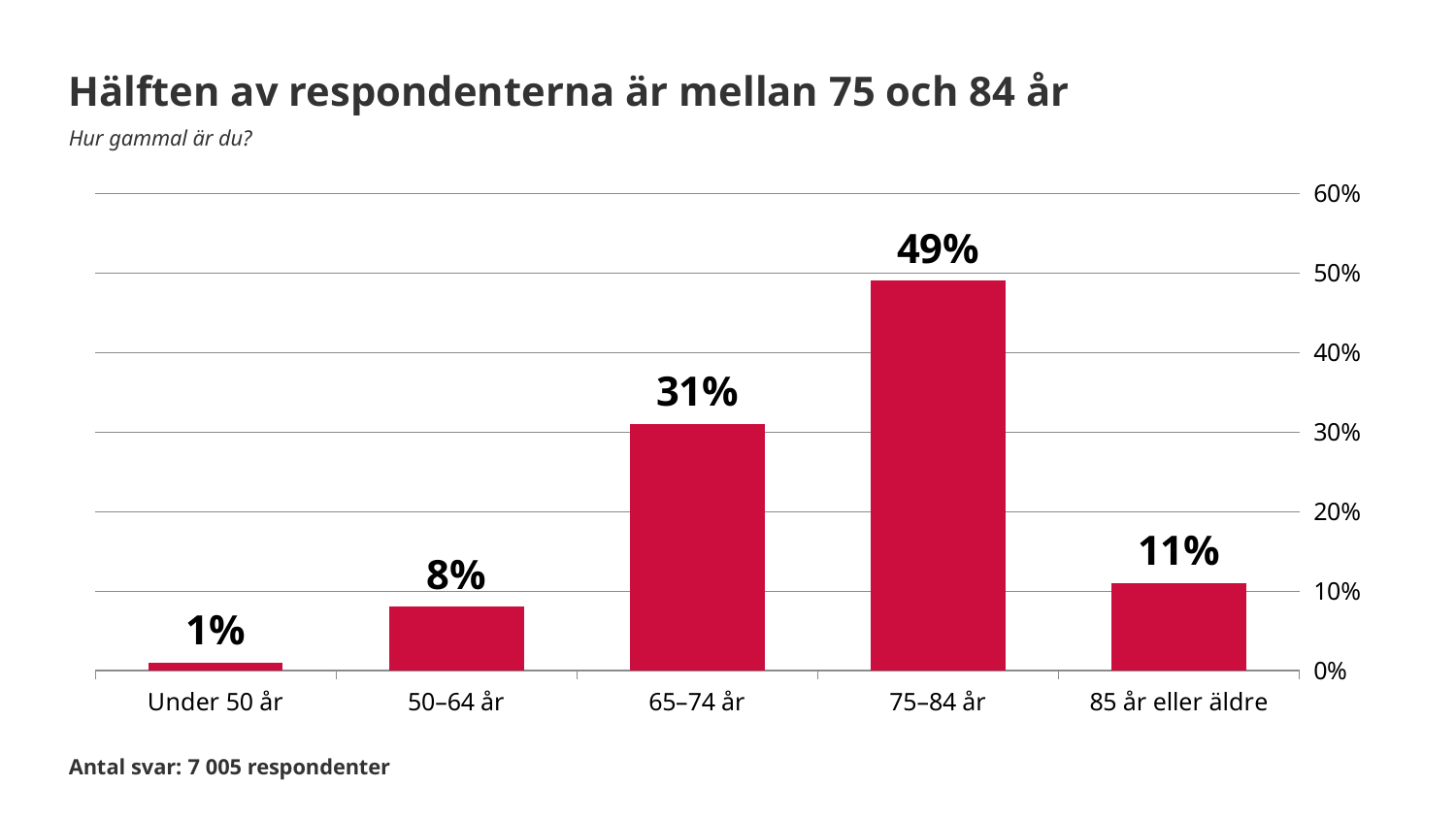
Which age group has the lowest share of respondents? Under 50 år What kind of chart is shown on the slide? Bar chart What is the title of the slide? Hälften av respondenterna är mellan 75 och 84 år What is the value shown for the 65–74 år category? 31% Is the value for 65–74 år greater or less than 30%? greater How many age categories are shown on the x axis? 5 What percentage of respondents are 85 år eller äldre? 11% What percentage of respondents are in the 75–84 år age group? 49% Which age group has the highest share of respondents? 75–84 år How many respondents answered the survey, according to the note below the chart? 7 005 respondenter Which is larger, the value for 50–64 år or the value for 85 år eller äldre? 85 år eller äldre What is the difference in percentage points between the 75–84 år and 65–74 år groups? 18 percentage points